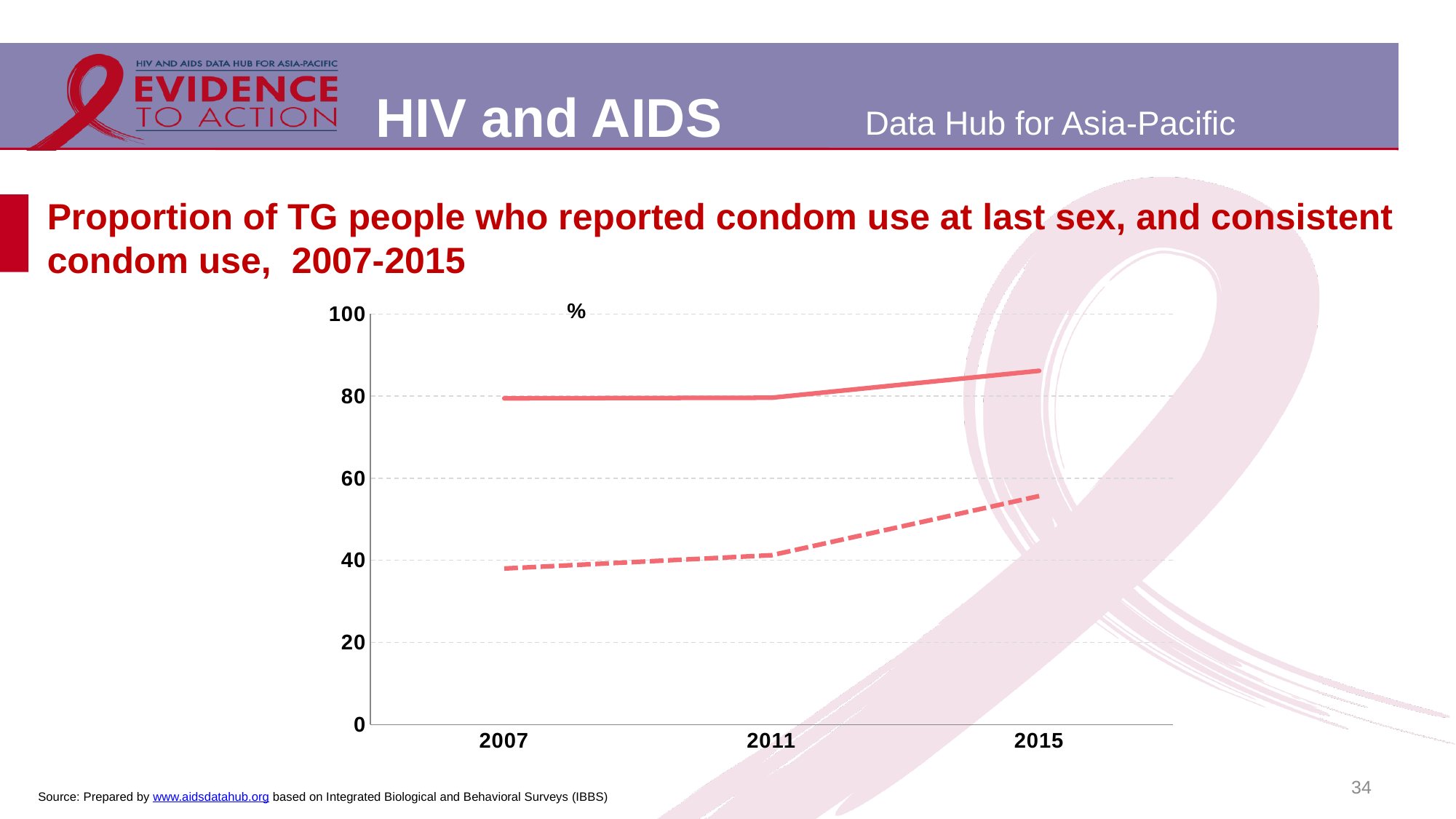
Is the value of the dashed line in 2015 greater or less than 40? greater Is the value of the solid line in 2007 greater or less than 60? greater In 2015, which line has the higher value, the solid line or the dashed line? solid line How many years are marked on the x axis of the chart? 3 Does the solid line rise or fall from 2007 to 2015? rise Is the value of the solid line in 2015 greater or less than 80? greater Which years are shown on the x axis of the chart? 2007, 2011, 2015 Does the dashed line rise or fall from 2007 to 2015? rise What unit is shown on the y axis of the chart? % What kind of chart is shown on the slide? line chart In which year does the dashed line reach its highest value? 2015